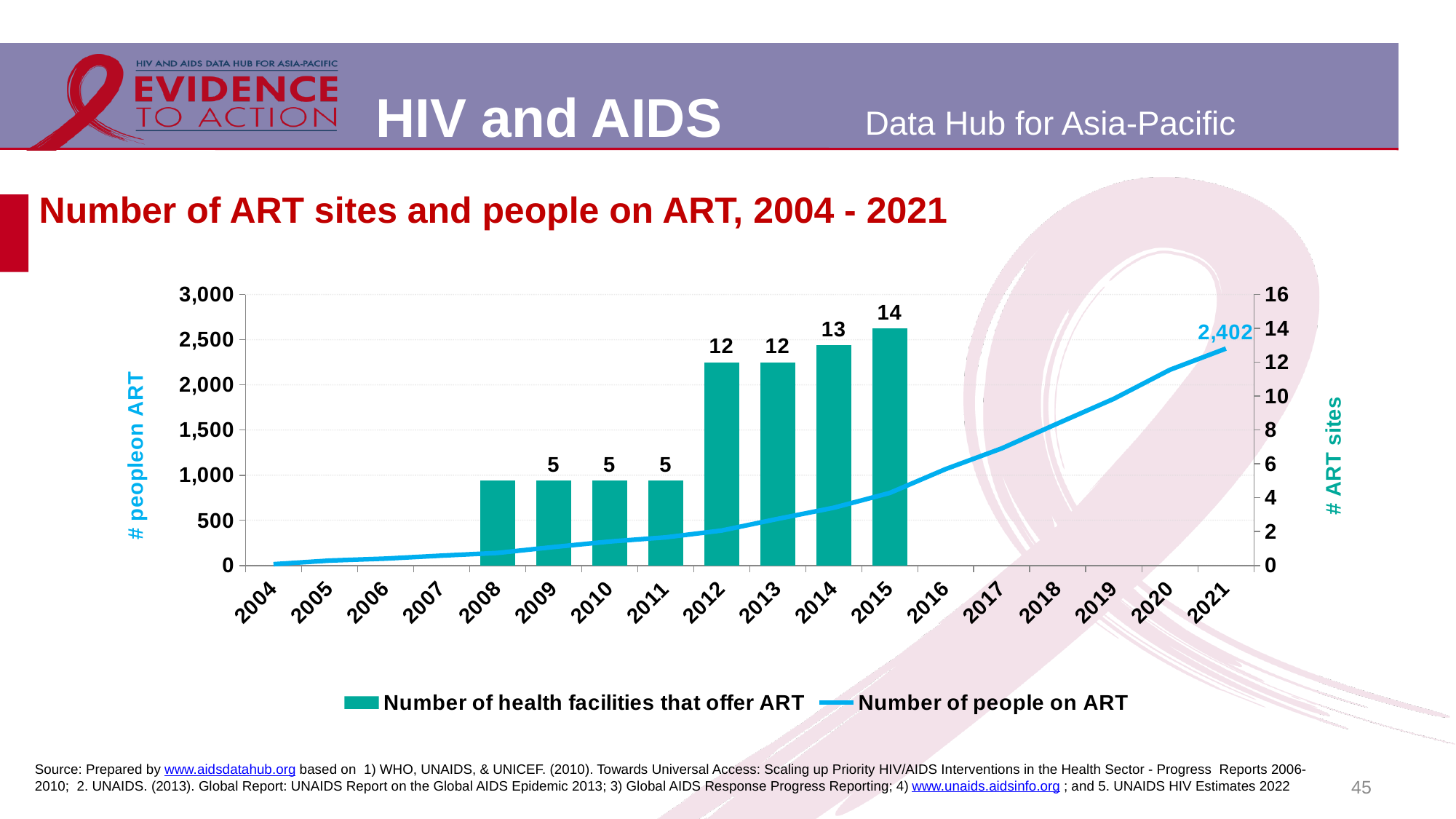
Does the number of people on ART rise or fall from 2004 to 2021? Rise What kind of chart is shown on the slide? Combination bar and line chart Is the number of people on ART in 2019 greater or less than 1,500? greater What is the title of the chart? Number of ART sites and people on ART, 2004 - 2021 What is the number of people on ART in 2021? 2,402 How many years have a bar for the number of health facilities that offer ART? 8 What is the difference between the number of health facilities offering ART in 2015 and in 2011? 9 How many series does the legend list? 2 Is the number of people on ART in 2010 greater or less than 500? less In which year was the number of health facilities that offer ART highest? 2015 Which year had more health facilities offering ART, 2013 or 2014? 2014 How many health facilities offered ART in 2015? 14